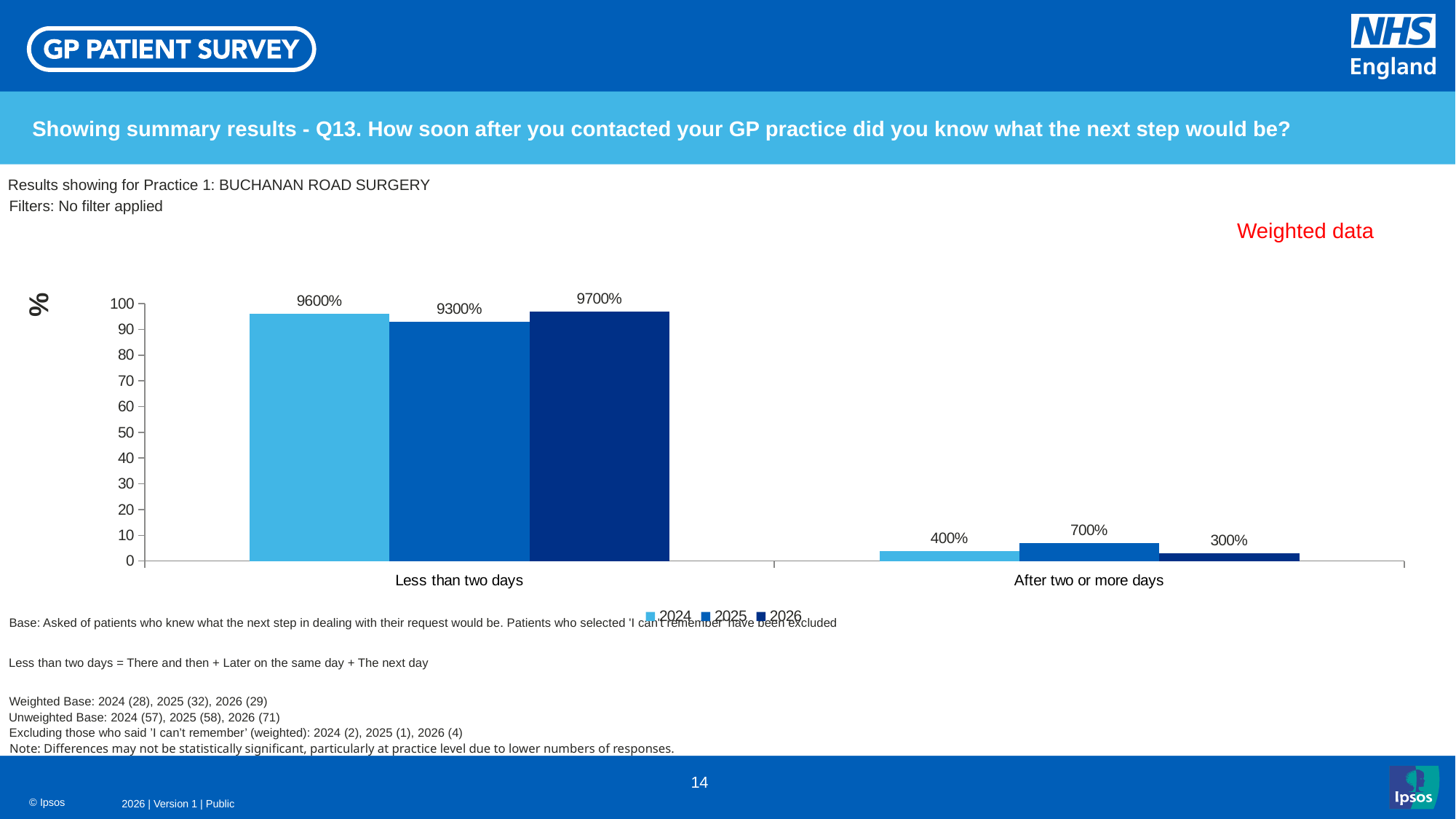
What is the value for 2024 in the 'Less than two days' category? 9600% What is the value for 2026 in the 'Less than two days' category? 9700% What is the value for 2025 in the 'After two or more days' category? 700% What is the value for 2026 in the 'After two or more days' category? 300% How many categories are shown on the x axis? 2 Which year has the lowest value in the 'After two or more days' category? 2026 Which year has the highest value in the 'Less than two days' category? 2026 What is the value for 2024 in the 'After two or more days' category? 400% Which is larger in the 'After two or more days' category: the value for 2024 or the value for 2025? 2025 How many series does the legend list? 3 What is the value for 2025 in the 'Less than two days' category? 9300% What kind of chart is shown on the slide? Bar chart